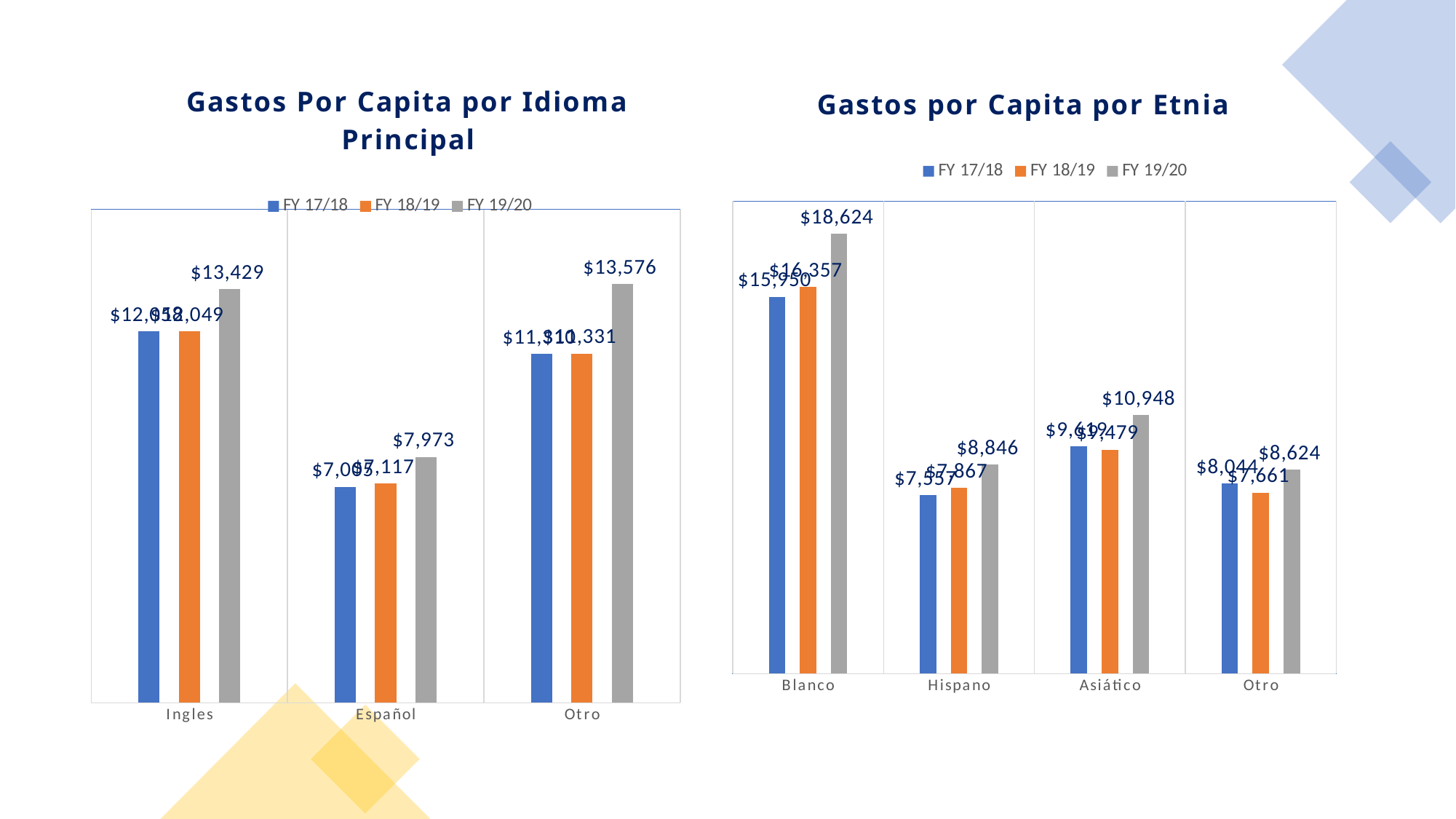
In the "Gastos por Capita por Etnia" chart, what is the FY 19/20 value for Asiático? $10,948 In the "Gastos por Capita por Etnia" chart, what is the FY 19/20 value for Blanco? $18,624 In the "Gastos Por Capita por Idioma Principal" chart, which category has the lowest FY 19/20 value? Español How many series does the legend of the "Gastos por Capita por Etnia" chart list? 3 In the "Gastos Por Capita por Idioma Principal" chart, what is the FY 19/20 value for Ingles? $13,429 In the "Gastos por Capita por Etnia" chart, what is the difference between the FY 19/20 and FY 18/19 values for Blanco? $2,267 In the "Gastos por Capita por Etnia" chart, which category has the highest FY 19/20 value? Blanco In the "Gastos Por Capita por Idioma Principal" chart, what is the difference between the FY 19/20 values for Otro and Ingles? $147 How many categories are shown on the x axis of the "Gastos Por Capita por Idioma Principal" chart? 3 In the "Gastos por Capita por Etnia" chart, which is larger for FY 19/20: Asiático or Otro? Asiático What kind of chart is "Gastos Por Capita por Idioma Principal"? bar chart In the "Gastos Por Capita por Idioma Principal" chart, what is the FY 19/20 value for Otro? $13,576